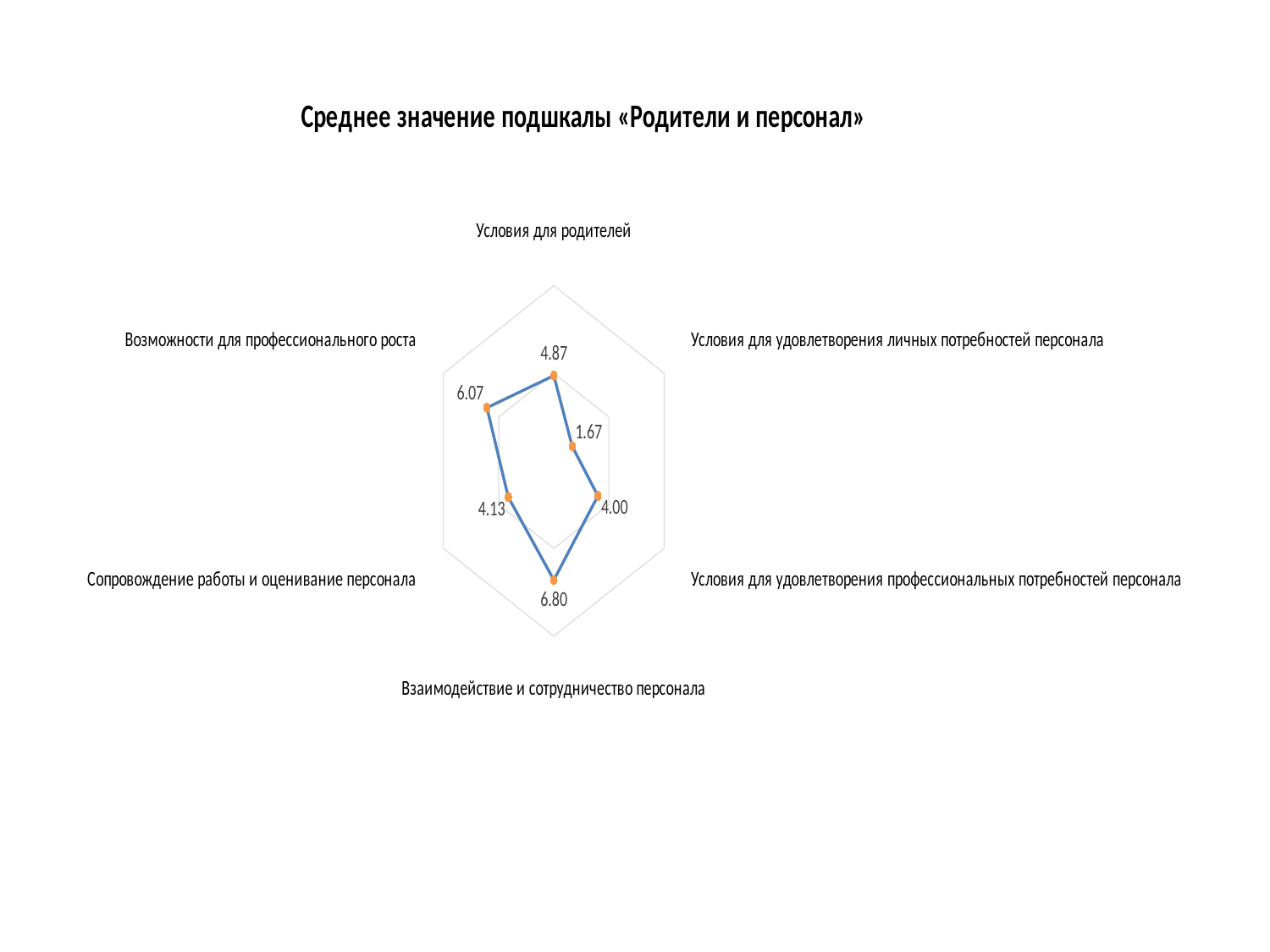
What is the title of the chart? Среднее значение подшкалы «Родители и персонал» What is the difference between the values for «Взаимодействие и сотрудничество персонала» and «Условия для удовлетворения профессиональных потребностей персонала»? 2.80 What is the value for «Условия для удовлетворения личных потребностей персонала»? 1.67 Which category has the lowest value? Условия для удовлетворения личных потребностей персонала What kind of chart is shown on the slide? Radar chart How many categories are plotted on the chart? 6 Which is larger: the value for «Возможности для профессионального роста» or the value for «Условия для родителей»? Возможности для профессионального роста What is the value for «Сопровождение работы и оценивание персонала»? 4.13 What is the value for «Взаимодействие и сотрудничество персонала»? 6.80 Which category has the highest value? Взаимодействие и сотрудничество персонала What is the value for «Возможности для профессионального роста»? 6.07 What is the value for «Условия для родителей»? 4.87